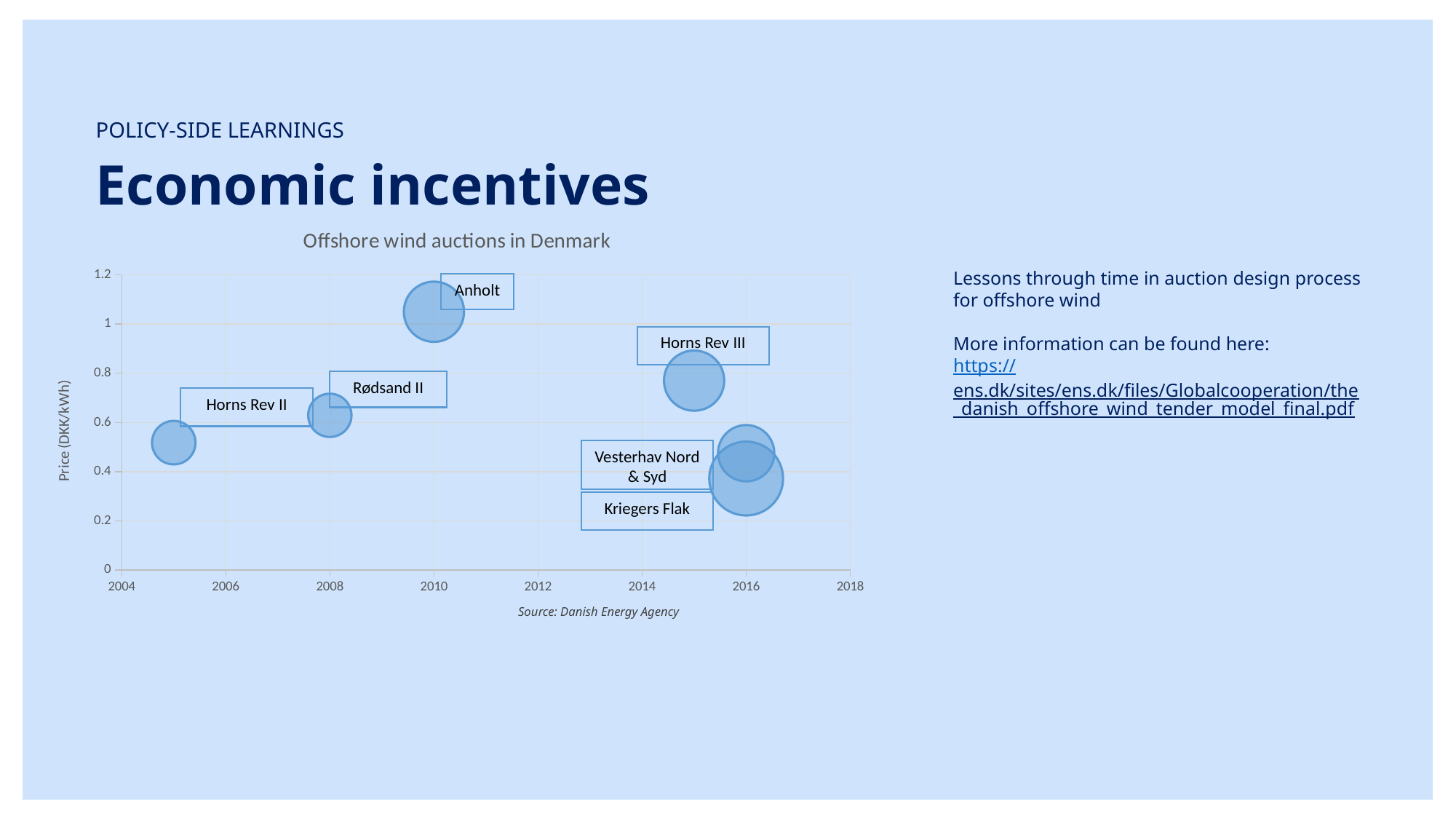
Is the price for Horns Rev III greater or less than 0.6 DKK/kWh? greater How many offshore wind auctions (bubbles) are plotted on the chart? 6 Which auction has the highest price on the chart? Anholt Which has the higher price, Horns Rev III or Rødsand II? Horns Rev III Which has the higher price, Anholt or Vesterhav Nord & Syd? Anholt What is the title of the chart? Offshore wind auctions in Denmark Which auction has the lowest price on the chart? Kriegers Flak Is the price for Kriegers Flak greater or less than 0.4 DKK/kWh? less What is the label of the vertical axis of the chart? Price (DKK/kWh) What kind of chart is shown on the slide? Bubble chart Is the price for Anholt greater or less than 1 DKK/kWh? greater